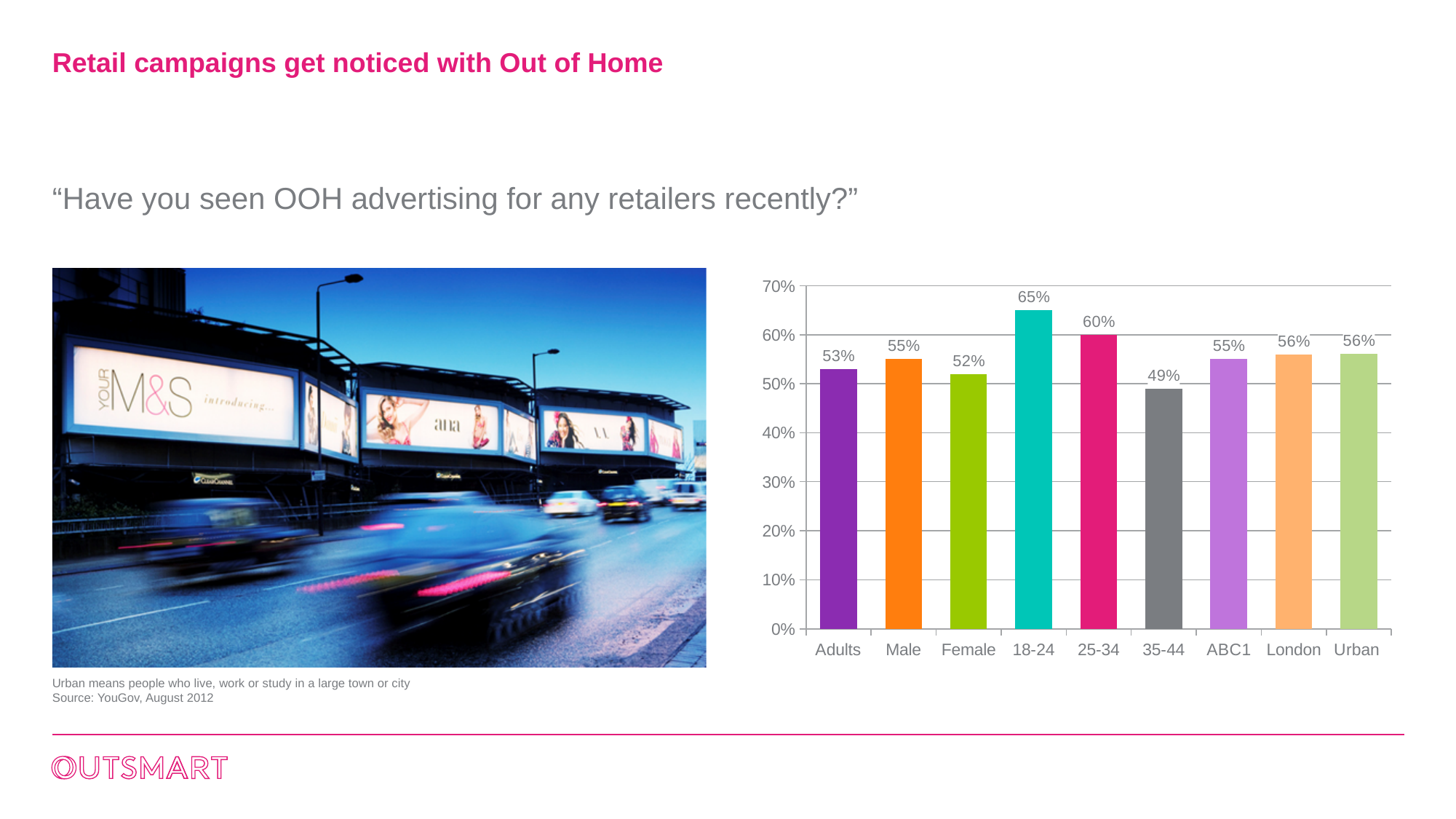
What is the value for Female? 52% Which category has the lowest value? 35-44 What is the value for 18-24? 65% Is the value for 35-44 greater or less than 50%? less What kind of chart is shown on the slide? bar chart How many categories are shown on the x axis? 9 What is the difference between the values for 18-24 and 35-44? 16% Which is larger, the value for 25-34 or the value for ABC1? 25-34 What is the value for London? 56% What is the value for Adults? 53% What is the difference between the values for Male and Female? 3% Which category has the highest value? 18-24